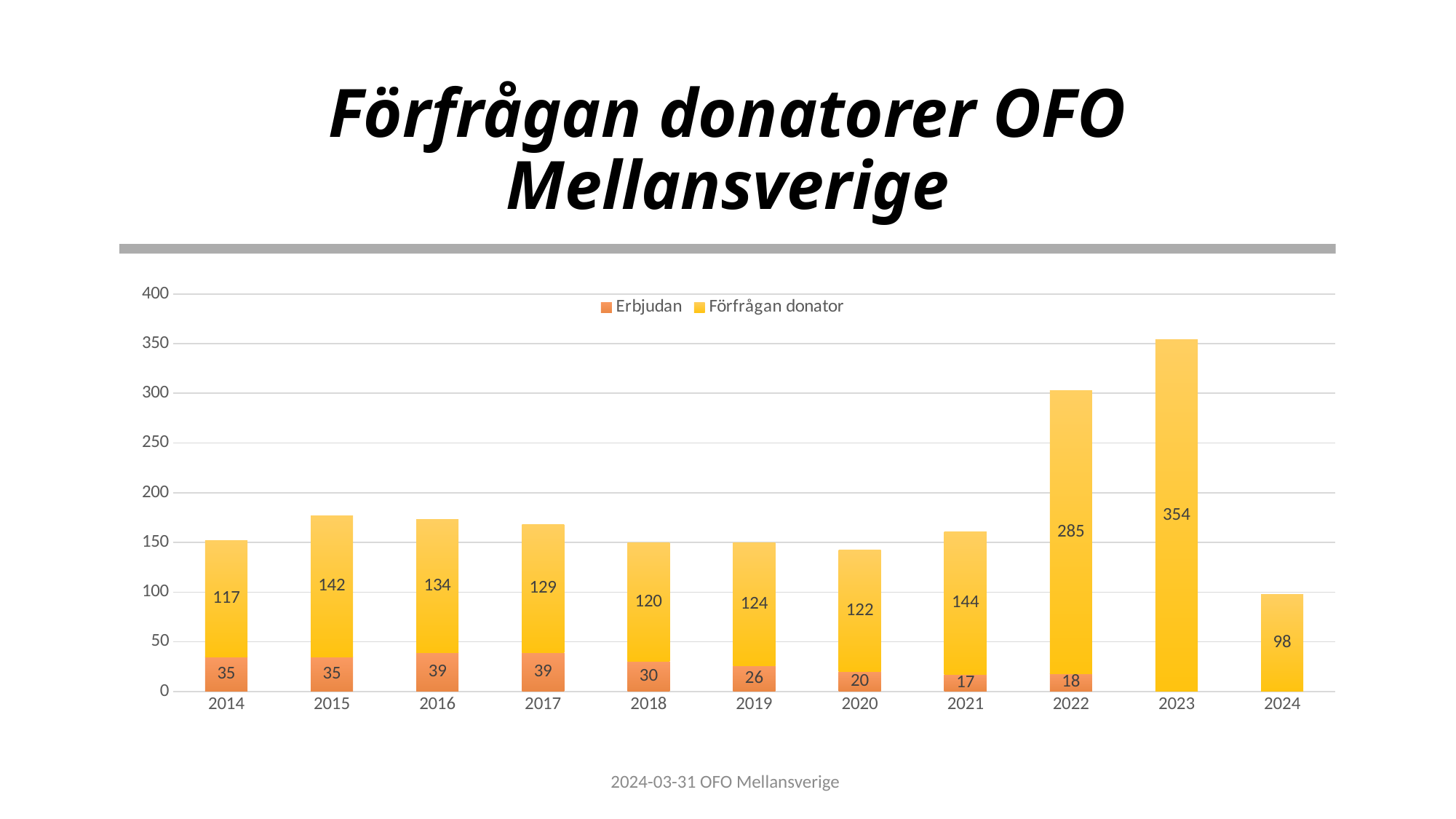
What is the total of the stacked bar for 2014? 152 Is the total height of the 2022 bar greater or less than 300? greater What is the Förfrågan donator value for 2022? 285 Which year has the highest Förfrågan donator value? 2023 What is the Erbjudan value for 2016? 39 Which is larger, the Förfrågan donator value for 2015 or for 2016? 2015 How many years are shown on the x axis? 11 How many series does the legend list? 2 What is the difference between the Förfrågan donator values for 2023 and 2022? 69 What is the Förfrågan donator value for 2024? 98 Which year has the lowest Erbjudan value among the years with an Erbjudan label? 2021 What kind of chart is shown on the slide? Stacked bar chart